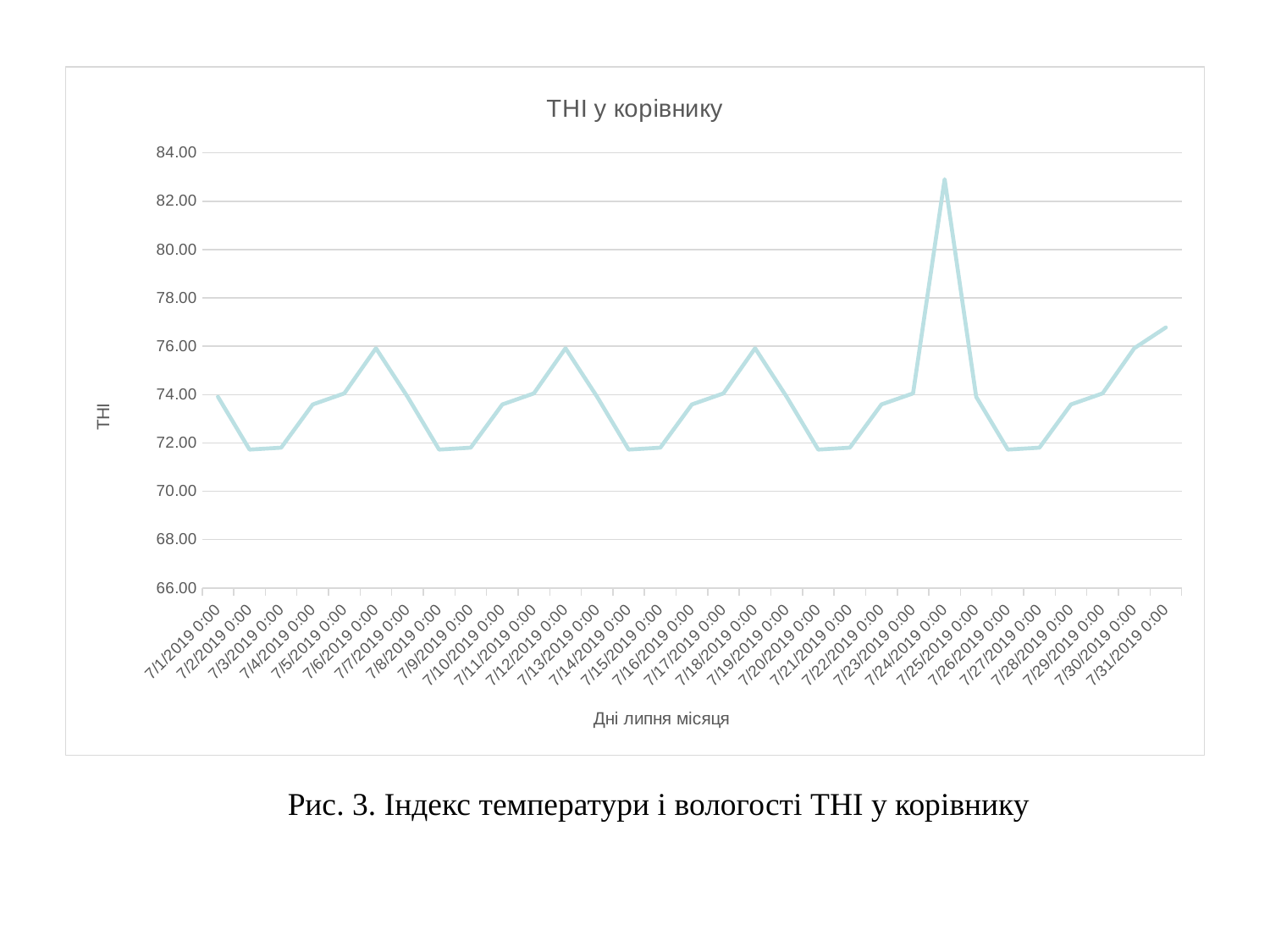
Is the value for 7/1/2019 0:00 greater or less than 76.00? less Which has the larger value, 7/24/2019 0:00 or 7/6/2019 0:00? 7/24/2019 0:00 What is the label of the x axis? Дні липня місяця On which date does the THI reach its highest value? 7/24/2019 0:00 Is the value for 7/2/2019 0:00 greater or less than 72.00? less Between 7/26/2019 0:00 and 7/31/2019 0:00, do the values rise or fall? rise Is the value for 7/6/2019 0:00 greater or less than 74.00? greater What is the title of the chart? THI у корівнику How many data points are plotted on the line? 31 Which has the larger value, 7/2/2019 0:00 or 7/6/2019 0:00? 7/6/2019 0:00 What kind of chart is shown on the slide? line chart